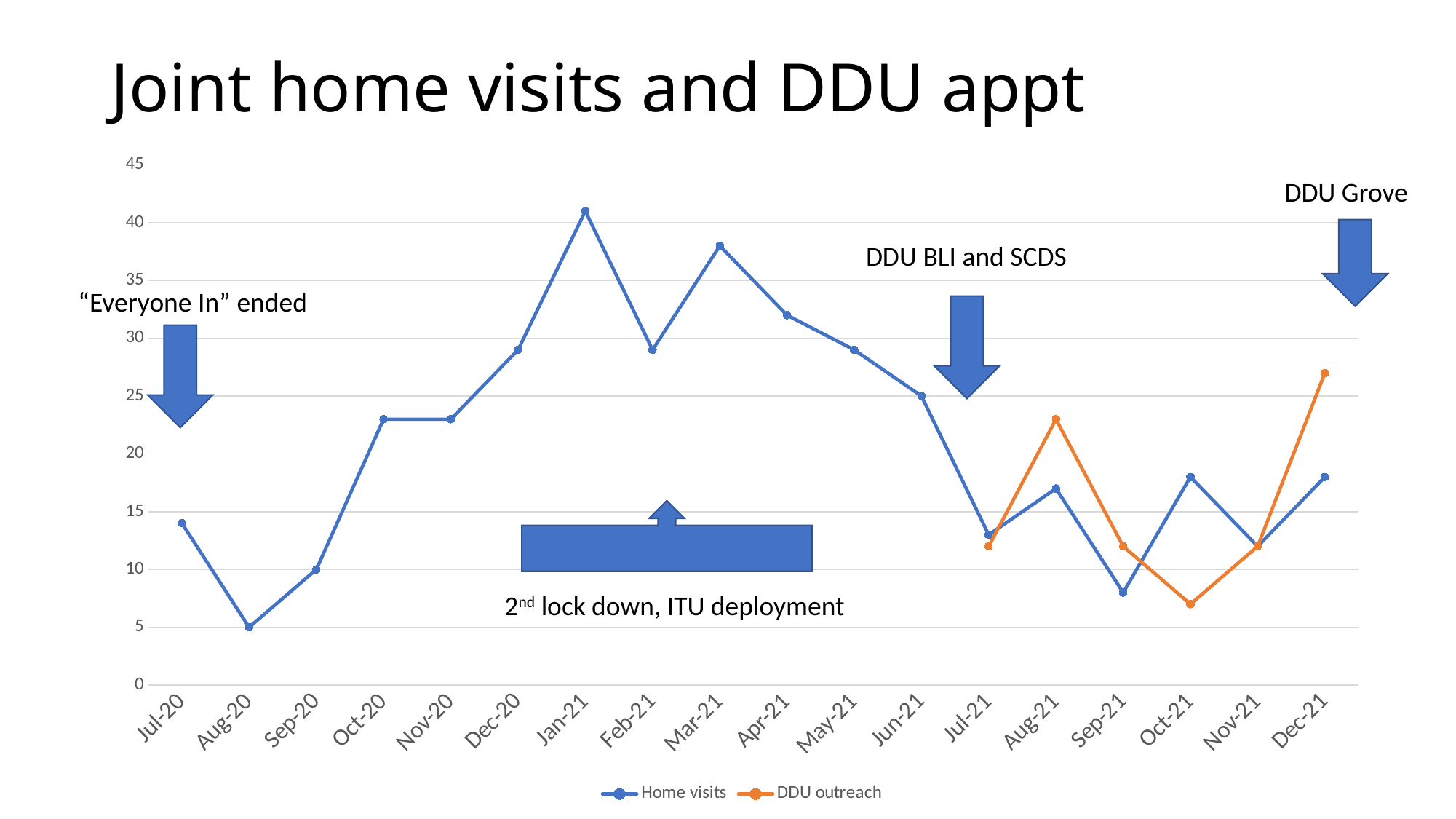
What is the Home visits value for Sep-20? 10 Is the Home visits value for Jan-21 greater or less than 40? greater How many months are shown along the x axis? 18 Is the DDU outreach value for Oct-21 greater or less than 10? less What kind of chart is shown on the slide? Line chart What colour is the DDU outreach line? Orange In Aug-21, which series has the larger value, Home visits or DDU outreach? DDU outreach In which month does the Home visits series reach its highest value? Jan-21 Do the Home visits values rise or fall from Sep-20 to Jan-21? Rise In which month does the Home visits series reach its lowest value? Aug-20 How many series does the legend list? 2 What is the Home visits value for Aug-20? 5